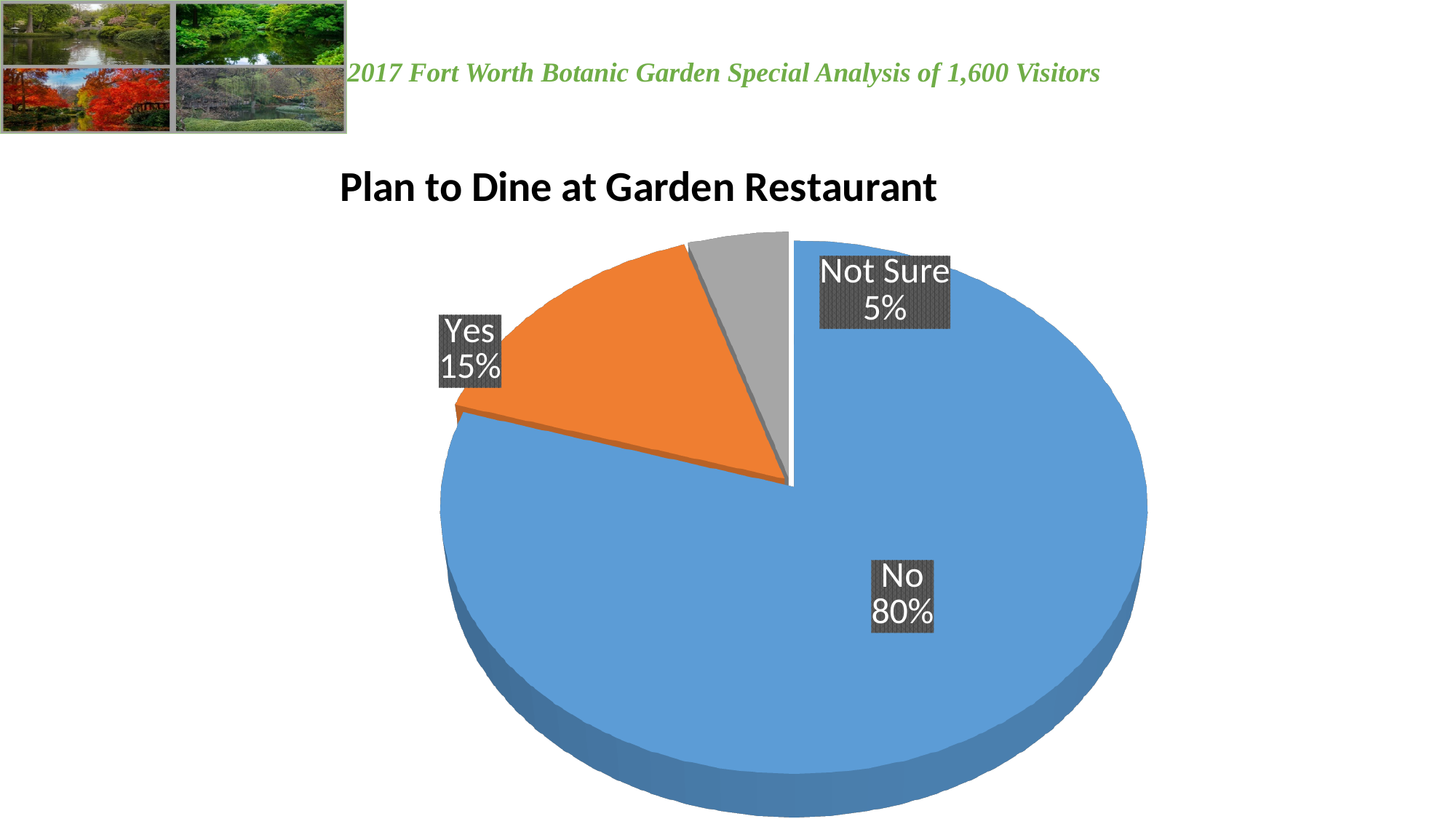
Which response has the smallest share of the pie? Not Sure What is the difference in percentage points between the "No" and "Yes" slices? 65 What percentage of visitors answered "Yes"? 15% What kind of chart is shown on the slide? Pie chart What is the difference in percentage points between the "Yes" and "Not Sure" slices? 10 How many slices does the pie chart have? 3 Which is larger, the "Yes" slice or the "Not Sure" slice? Yes Which response has the largest share of the pie? No What percentage of visitors answered "Not Sure"? 5% What is the title of the chart? Plan to Dine at Garden Restaurant What colour is the "No" slice? Blue What percentage of visitors answered "No"? 80%